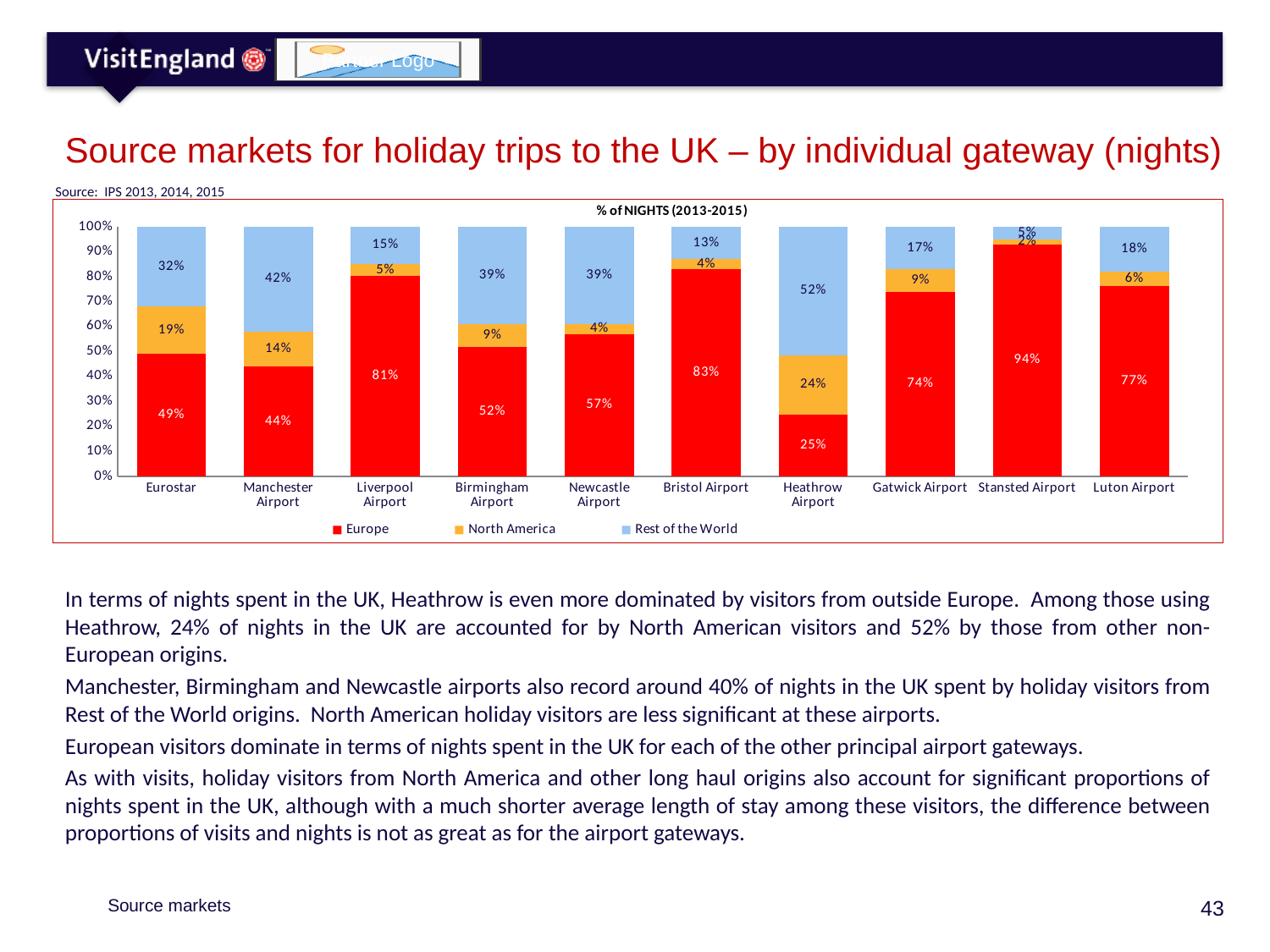
What is the Europe share of nights for Heathrow Airport? 25% Which is larger: the Europe share for Liverpool Airport or the Europe share for Luton Airport? Liverpool Airport Which gateway has the lowest Europe share of nights? Heathrow Airport What is the title of the chart? % of NIGHTS (2013-2015) What is the North America share of nights for Eurostar? 19% What is the difference between the Europe share for Bristol Airport and the Europe share for Birmingham Airport? 31% Which gateway has the highest Rest of the World share of nights? Heathrow Airport How many series does the chart legend list? 3 What type of chart is shown on the slide? Stacked bar chart What is the Rest of the World share of nights for Manchester Airport? 42% How many gateways are shown on the x axis of the chart? 10 Which gateway has the highest Europe share of nights? Stansted Airport